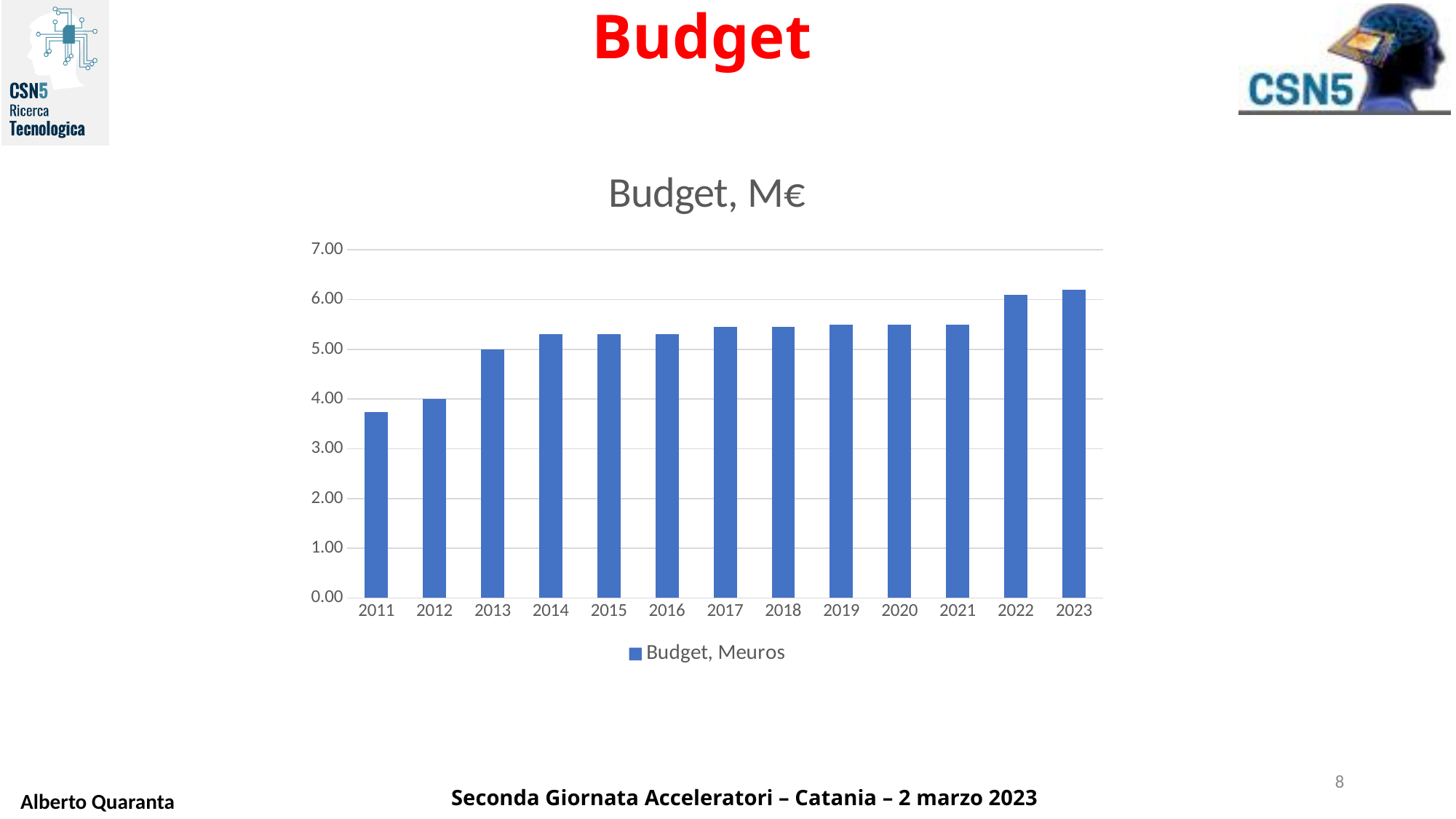
What is the legend entry of the chart? Budget, Meuros Is the budget value for 2011 greater or less than 4.00? less What is the title of the chart? Budget, M€ What is the budget value for 2013? 5.00 What is the budget value for 2012? 4.00 Do the budget values generally rise or fall from 2011 to 2023? rise How many years are shown on the x axis of the chart? 13 Which year has the lowest budget? 2011 How many series does the legend list? 1 What kind of chart is shown on the slide? bar chart Is the budget value for 2022 greater or less than 6.00? greater Which year has the larger budget, 2021 or 2022? 2022